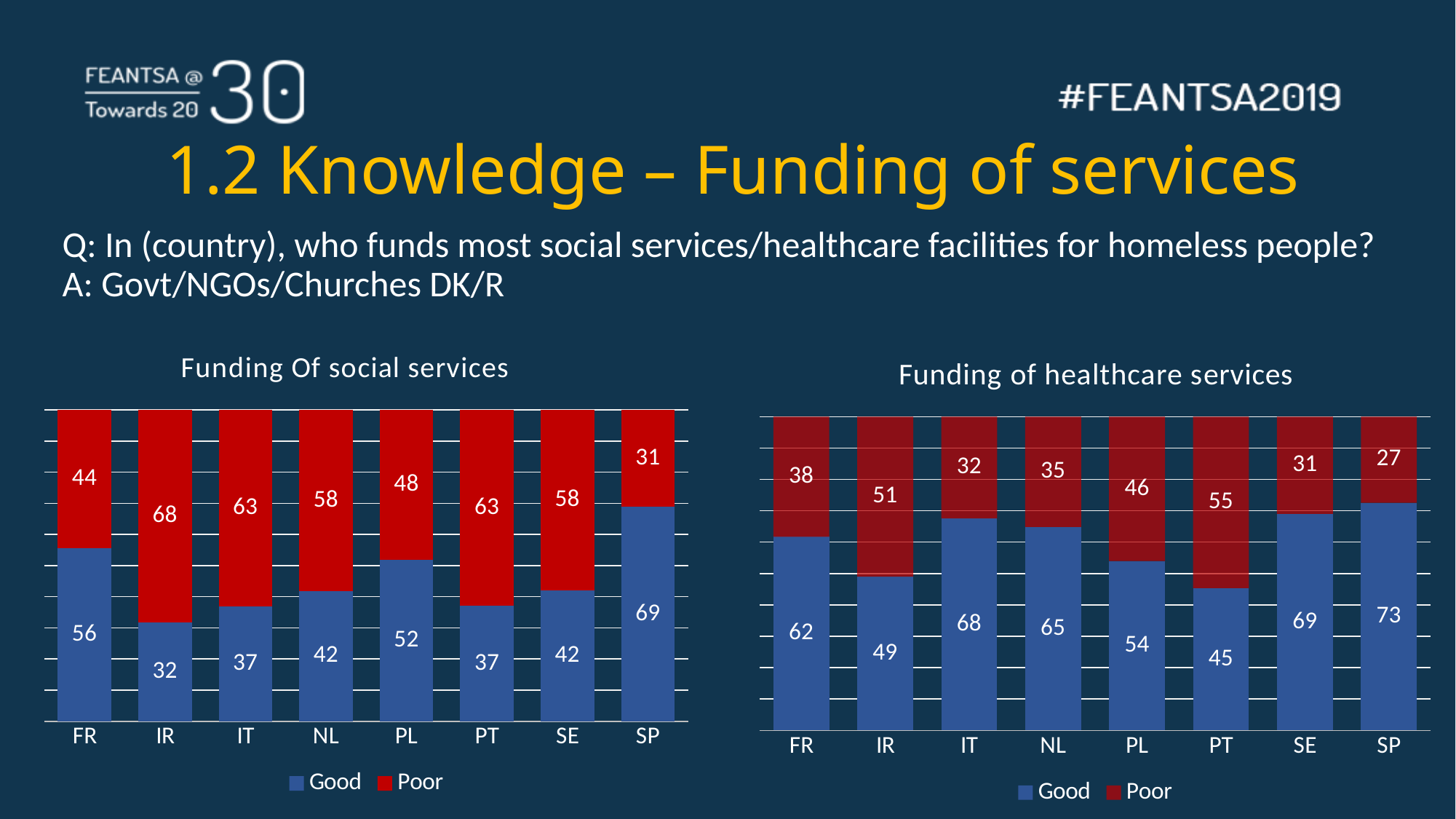
What type of chart is the 'Funding of healthcare services' chart? Stacked bar chart How many series does the legend of the 'Funding Of social services' chart list? 2 In the 'Funding Of social services' chart, what is the Good value for FR? 56 In the 'Funding Of social services' chart, which country has the highest Good value? SP In the 'Funding Of social services' chart, which country has the lowest Good value? IR In the 'Funding of healthcare services' chart, which country has the highest Poor value? PT How many countries are shown on the x axis of the 'Funding of healthcare services' chart? 8 In the 'Funding Of social services' chart, what is the Poor value for IR? 68 In the 'Funding Of social services' chart, which is larger, the Good value for PL or the Good value for NL? PL In the 'Funding of healthcare services' chart, what is the Good value for PT? 45 In the 'Funding of healthcare services' chart, what is the difference between the Good values for SP and IR? 24 In the 'Funding of healthcare services' chart, what is the Poor value for SP? 27